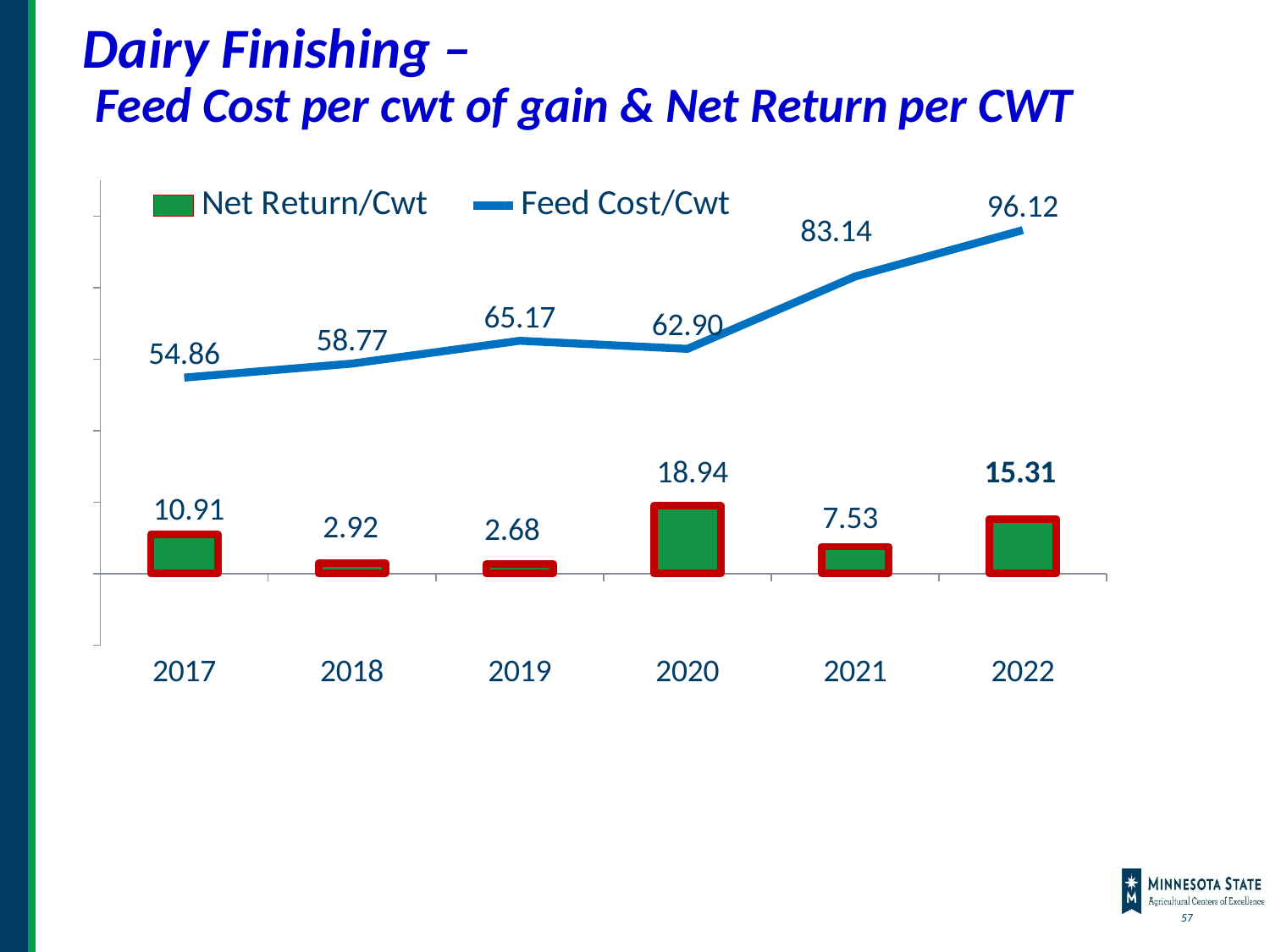
Which year has the highest Net Return/Cwt? 2020 What is the difference between the Feed Cost/Cwt in 2022 and in 2021? 12.98 How many series does the legend list? 2 Which series is shown as a blue line? Feed Cost/Cwt What is the Feed Cost/Cwt value for 2022? 96.12 Which year has the lowest Feed Cost/Cwt? 2017 How many years are shown on the x axis? 6 Does the Feed Cost/Cwt line rise or fall from 2020 to 2022? rise What is the Net Return/Cwt value for 2020? 18.94 What is the Feed Cost/Cwt value for 2017? 54.86 Which is larger, the Net Return/Cwt in 2017 or in 2021? 2017 What is the Net Return/Cwt value for 2019? 2.68